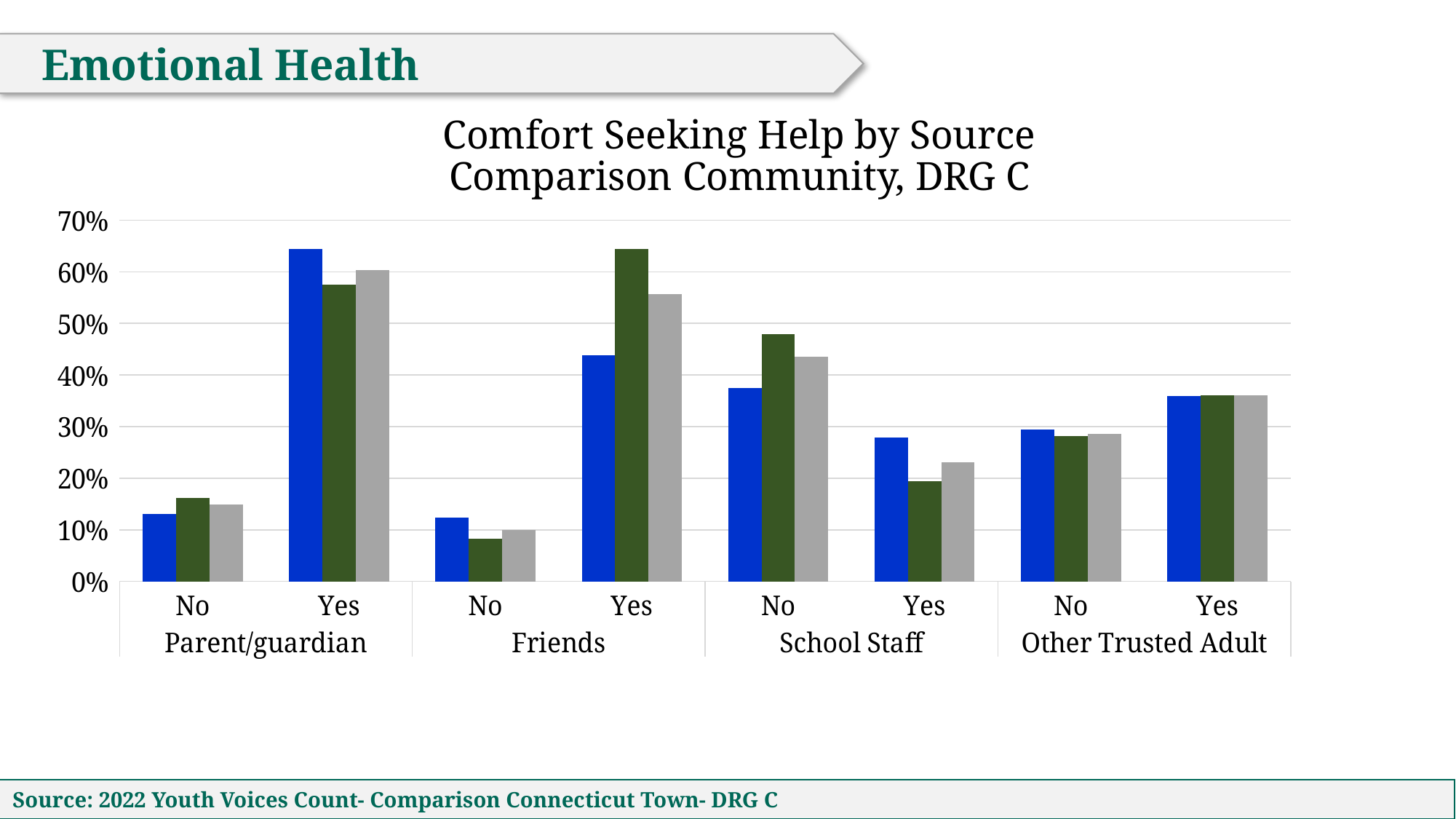
Which category has the tallest blue bar in the chart? Parent/guardian Yes For Friends Yes, which bar is taller, the blue bar or the green bar? green What kind of chart is shown on the slide? bar chart Is the green bar for School Staff No greater or less than 40%? greater How many bars are plotted for each No/Yes category in the chart? 3 Is the blue bar for Friends Yes greater or less than 50%? less How many help sources are shown along the x axis of the chart? 4 Is the blue bar for Parent/guardian Yes greater or less than 60%? greater What is the title of the chart? Comfort Seeking Help by Source Comparison Community, DRG C For School Staff Yes, which bar is taller, the blue bar or the green bar? blue Which category has the shortest green bar in the chart? Friends No